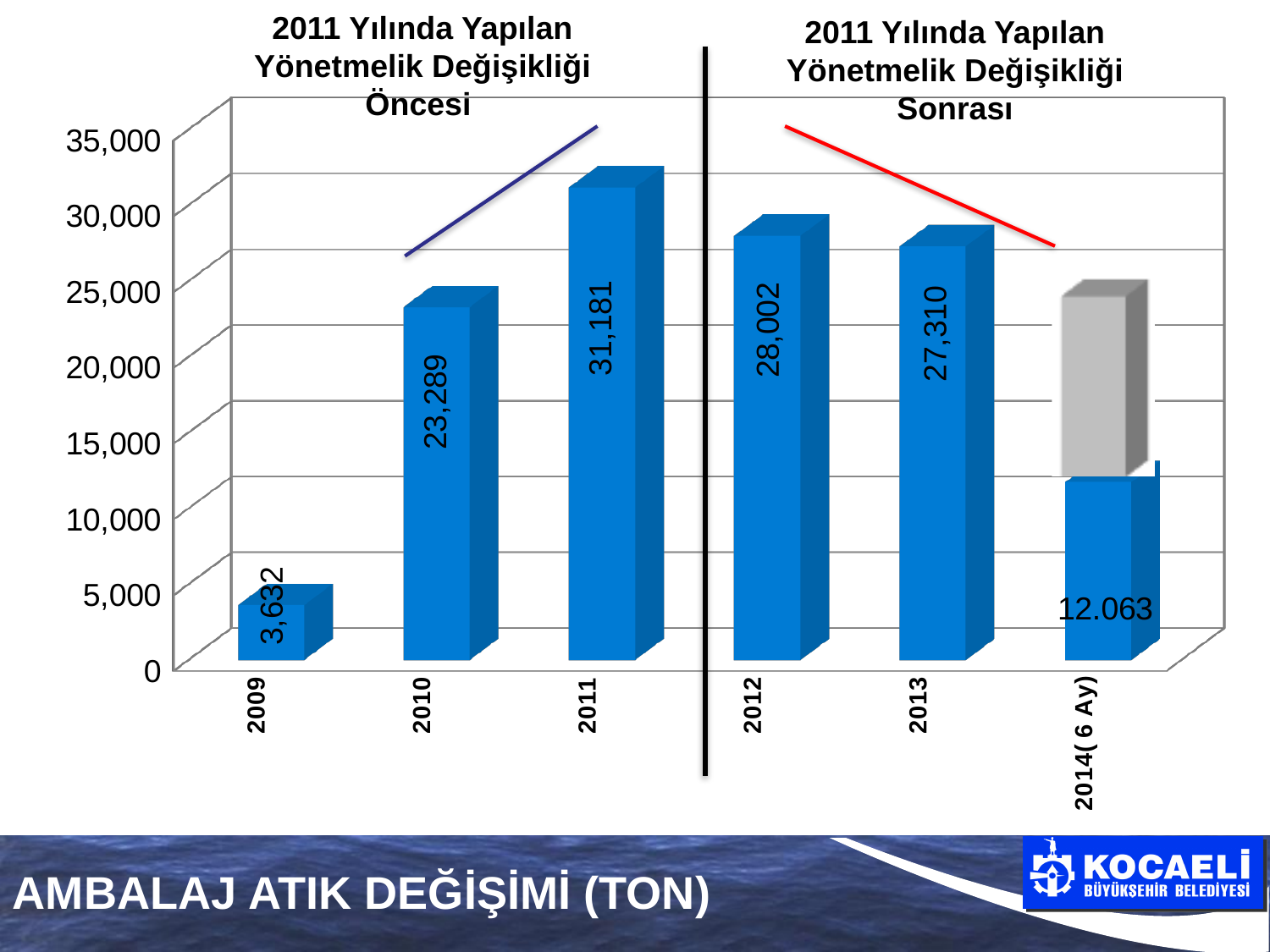
How many years (categories) are shown on the x axis? 6 What is the value for 2009? 3,632 Do the values rise or fall from 2009 to 2011? Rise Which year has the highest value? 2011 Which is larger, the value for 2012 or the value for 2013? 2012 What kind of chart is shown on the slide? Bar chart What is the value for 2011? 31,181 Which year has the lowest value? 2009 What is the value for 2013? 27,310 What is the difference between the values for 2011 and 2010? 7,892 What is the difference between the values for 2012 and 2013? 692 What is the value shown for 2014 (6 Ay)? 12.063